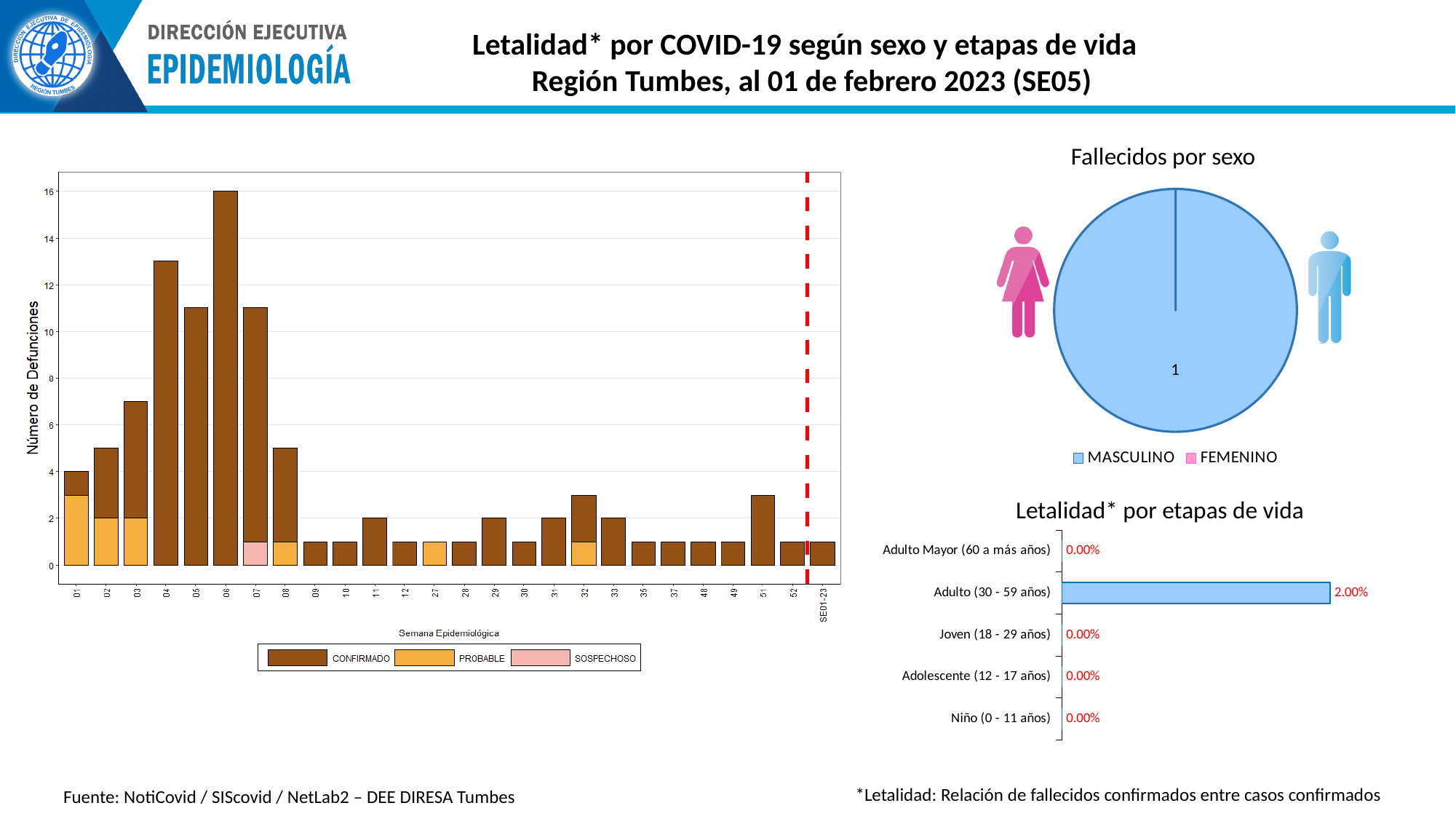
In the bar chart on the left showing Número de Defunciones by Semana Epidemiológica, is the value for week 04 greater or less than 12? greater How many series does the legend of the 'Fallecidos por sexo' chart list? 2 In the 'Letalidad* por etapas de vida' chart, what is the difference between the values for Adulto (30 - 59 años) and Joven (18 - 29 años)? 2.00% How many series does the legend of the bar chart on the left (Número de Defunciones) list? 3 In the 'Letalidad* por etapas de vida' chart, which age group has the highest value? Adulto (30 - 59 años) In the bar chart on the left showing Número de Defunciones by Semana Epidemiológica, which week has the highest bar? 06 In the 'Letalidad* por etapas de vida' chart, what is the value for Adulto Mayor (60 a más años)? 0.00% How many age groups are shown in the 'Letalidad* por etapas de vida' chart? 5 In the 'Letalidad* por etapas de vida' chart, what is the value for Adulto (30 - 59 años)? 2.00% In the 'Fallecidos por sexo' chart, what share of the pie does the MASCULINO slice represent? 100% What kind of chart is 'Fallecidos por sexo'? Pie chart In the 'Fallecidos por sexo' chart, what value is shown for the MASCULINO slice? 1